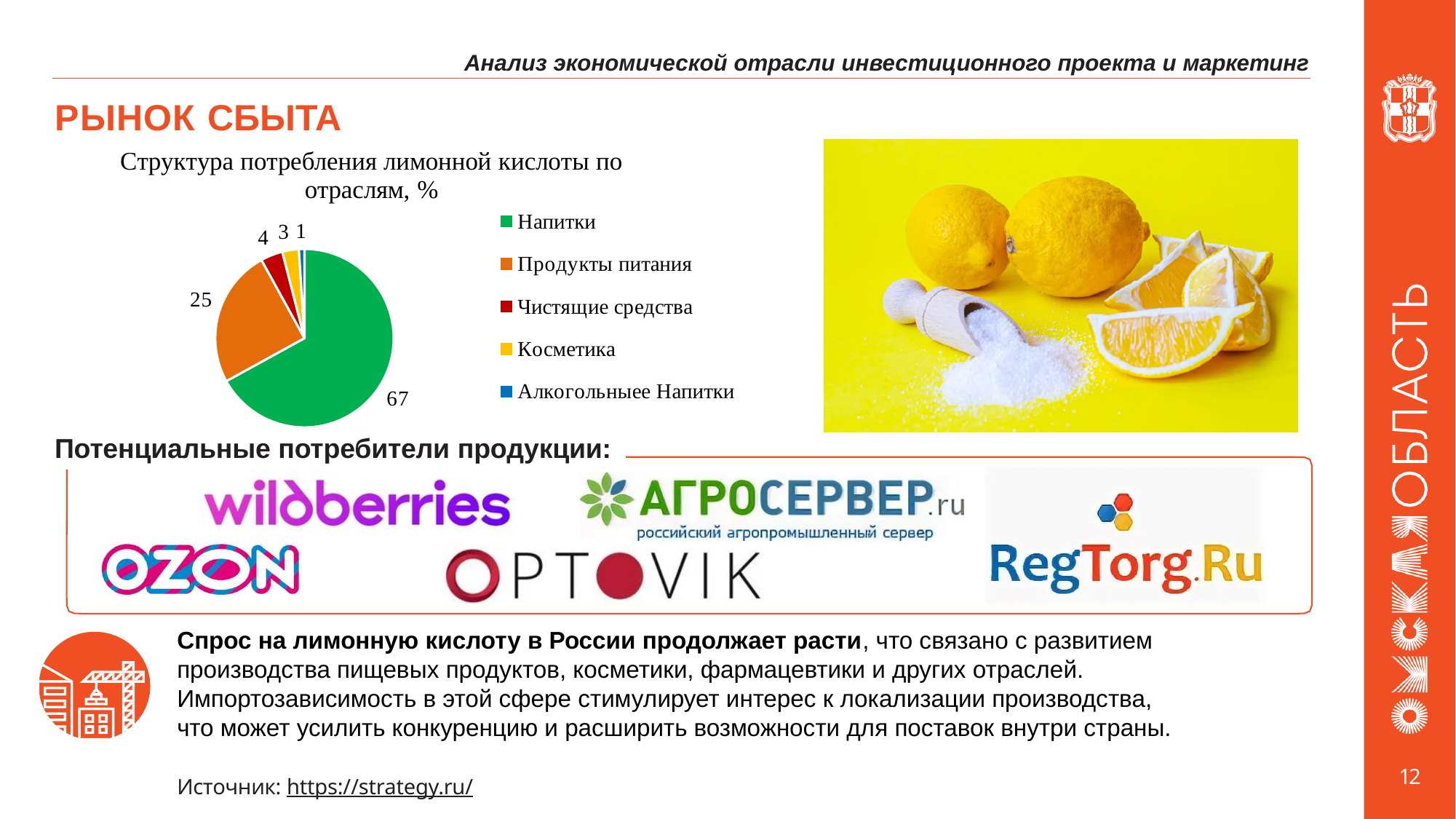
What is the value for Напитки in the pie chart? 67 What is the value for Продукты питания in the pie chart? 25 What is the title of the chart? Структура потребления лимонной кислоты по отраслям, % Which is larger, the value for Чистящие средства or the value for Косметика? Чистящие средства What is the value for Чистящие средства in the pie chart? 4 How many categories does the legend of the pie chart list? 5 What type of chart is shown on the slide? Pie chart What is the difference between the values for Напитки and Продукты питания? 42 What is the value for Алкогольныее Напитки in the pie chart? 1 Which category has the largest share of the pie chart? Напитки Which category has the smallest share of the pie chart? Алкогольныее Напитки What is the value for Косметика in the pie chart? 3